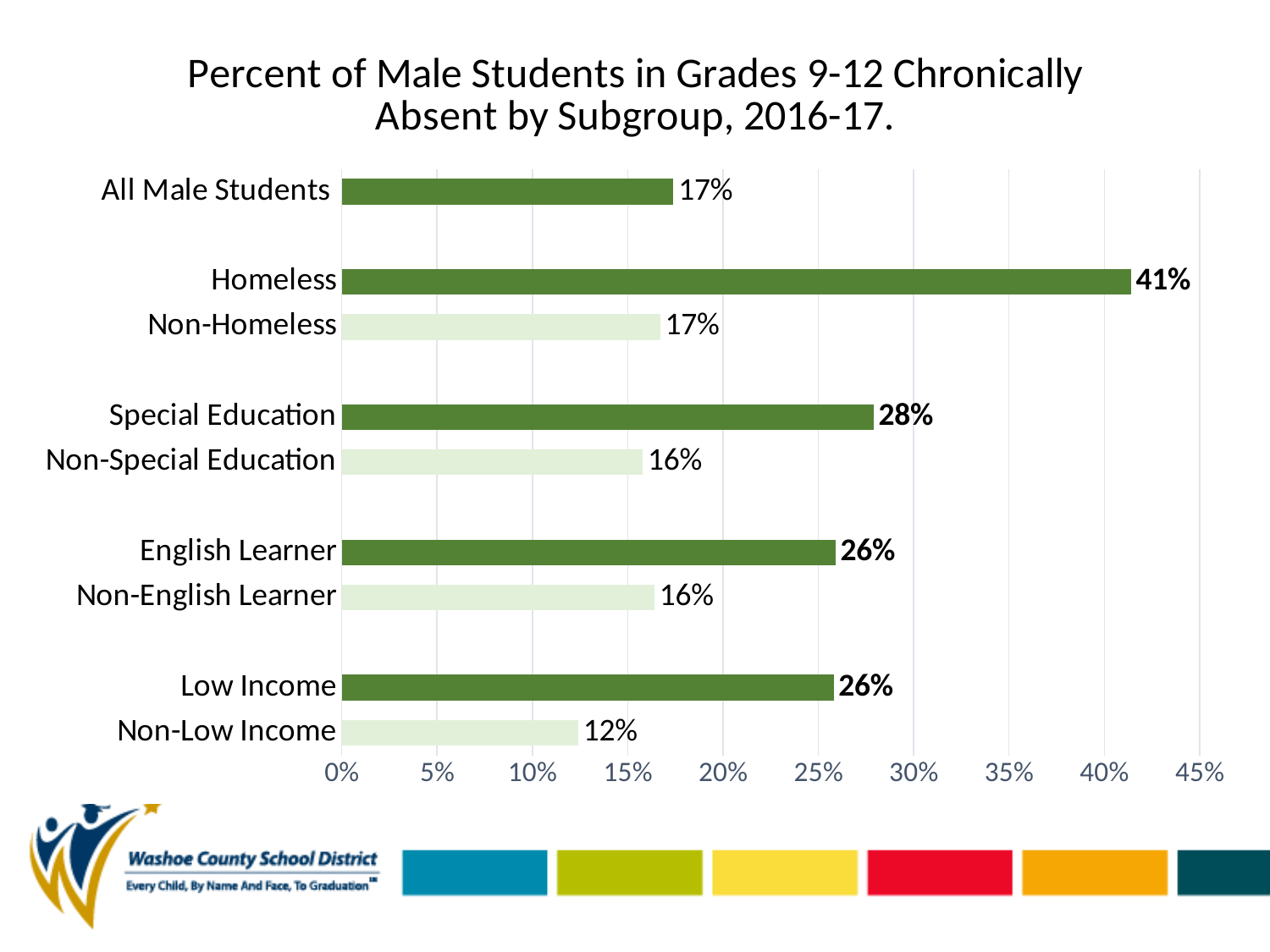
How many subgroup categories are shown in the chart? 9 What is the value for Special Education? 28% Is the value for Low Income greater or less than 20%? greater What is the difference between the values for Special Education and Non-Special Education? 12% What is the value for Homeless? 41% Which subgroup has the highest percent of chronically absent male students? Homeless What kind of chart is shown on the slide? Bar chart What is the value for All Male Students? 17% Which is larger, the value for English Learner or the value for Special Education? Special Education What is the difference between the values for Homeless and Non-Homeless? 24% Which subgroup has the lowest percent of chronically absent male students? Non-Low Income What is the value for Non-Low Income? 12%